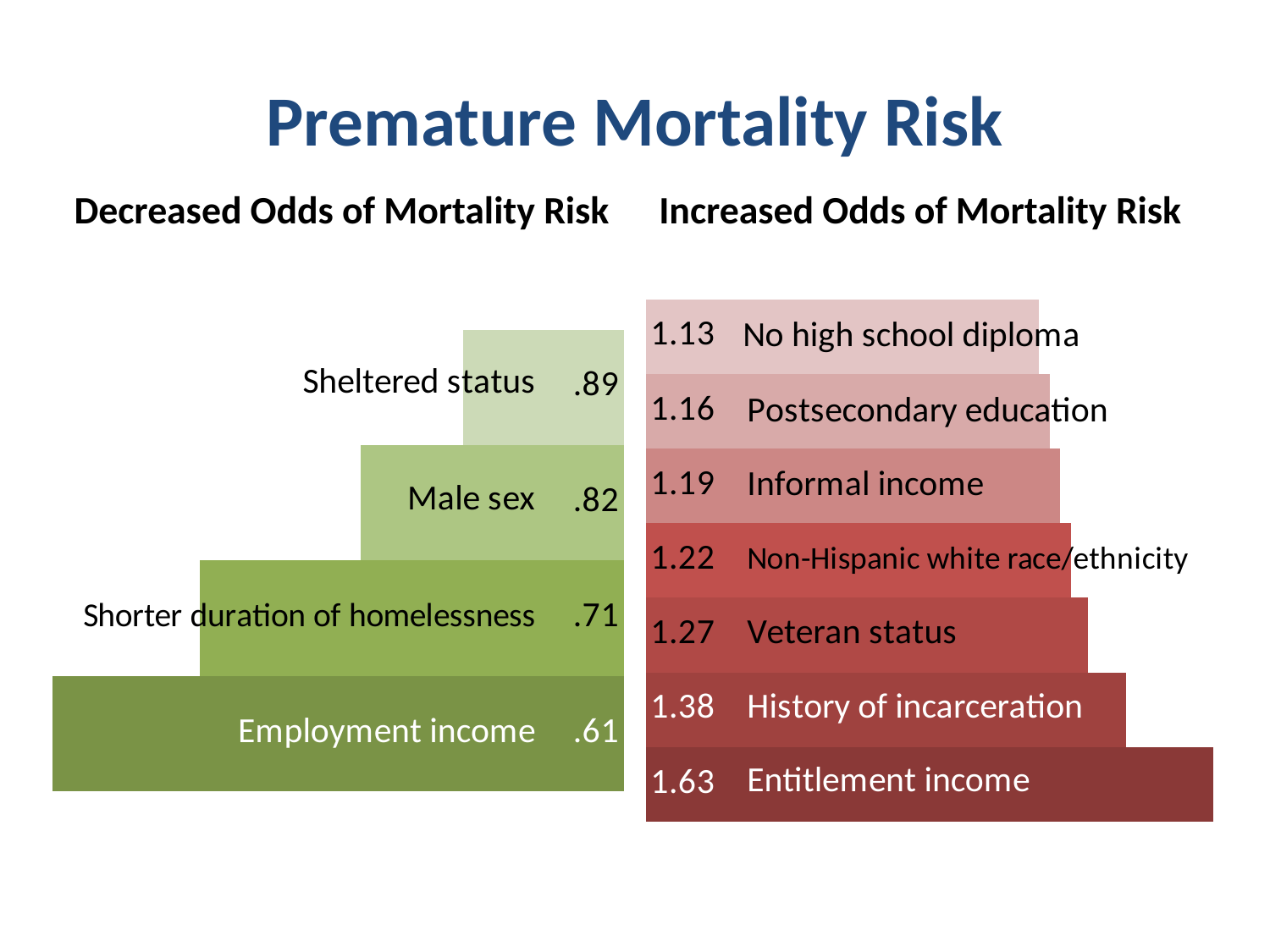
In the Decreased Odds of Mortality Risk chart, what is the value for Employment income? .61 In the Increased Odds of Mortality Risk chart, what is the value for History of incarceration? 1.38 How many categories are shown in the Increased Odds of Mortality Risk chart? 7 In the Increased Odds of Mortality Risk chart, what is the value for Veteran status? 1.27 In the Increased Odds of Mortality Risk chart, which is larger: the value for Postsecondary education or the value for Non-Hispanic white race/ethnicity? Non-Hispanic white race/ethnicity How many categories are shown in the Decreased Odds of Mortality Risk chart? 4 In the Increased Odds of Mortality Risk chart, what is the difference between the values for Entitlement income and Informal income? 0.44 In the Increased Odds of Mortality Risk chart, which category has the lowest value? No high school diploma In the Decreased Odds of Mortality Risk chart, what is the difference between the values for Sheltered status and Shorter duration of homelessness? .18 In the Decreased Odds of Mortality Risk chart, which category has the lowest value? Employment income In the Decreased Odds of Mortality Risk chart, what is the value for Male sex? .82 In the Increased Odds of Mortality Risk chart, which category has the highest value? Entitlement income